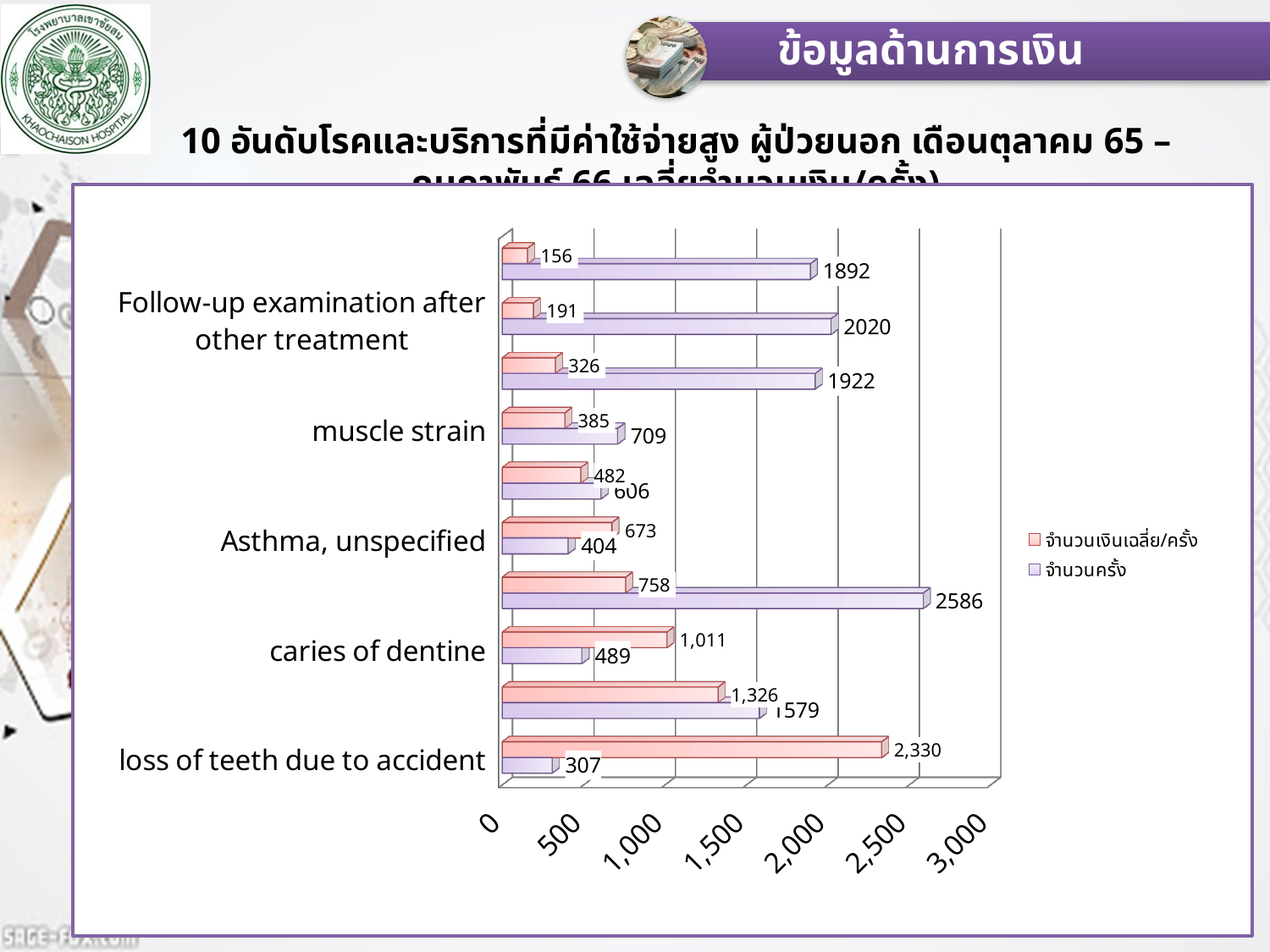
Is the จำนวนครั้ง value for Follow-up examination after other treatment greater or less than 1,500? greater What is the value of จำนวนครั้ง for Follow-up examination after other treatment? 2020 What is the difference between the จำนวนเงินเฉลี่ย/ครั้ง value and the จำนวนครั้ง value for loss of teeth due to accident? 2,023 What is the value of จำนวนครั้ง for caries of dentine? 489 What is the value of จำนวนเงินเฉลี่ย/ครั้ง for Asthma, unspecified? 673 Which category has the highest จำนวนเงินเฉลี่ย/ครั้ง value? loss of teeth due to accident How many series does the legend list? 2 Which is larger for caries of dentine: จำนวนเงินเฉลี่ย/ครั้ง or จำนวนครั้ง? จำนวนเงินเฉลี่ย/ครั้ง What is the value of จำนวนครั้ง for muscle strain? 709 How many categories are plotted in the chart? 10 What is the value of จำนวนเงินเฉลี่ย/ครั้ง for loss of teeth due to accident? 2,330 What kind of chart is shown on the slide? bar chart